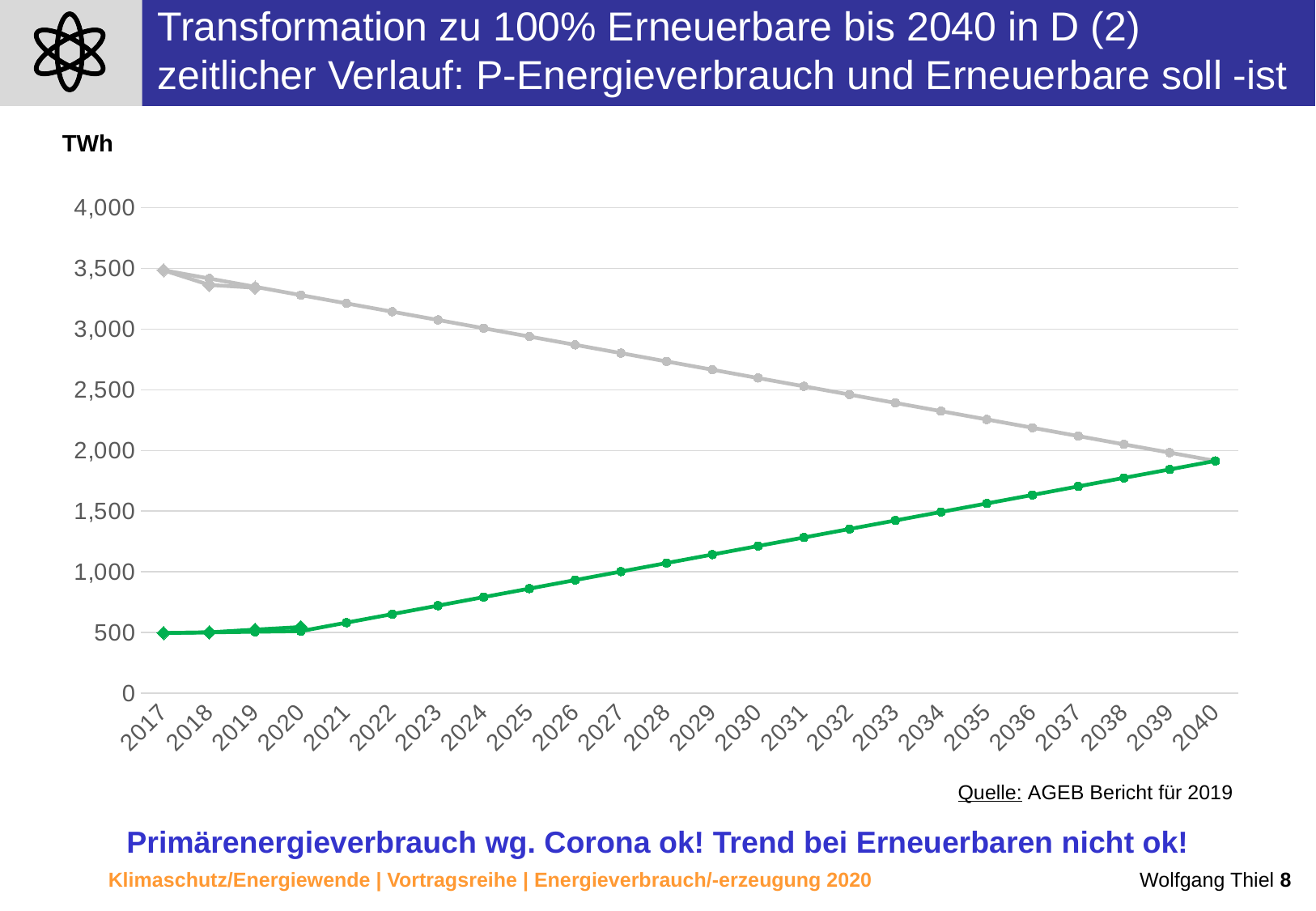
Is the value of the grey line in 2017 greater or less than 3,000? greater Is the value of the green line in 2017 greater or less than 1,000? less Which line has the larger value in 2017, the grey line or the green line? the grey line In which year does the grey line have its highest value? 2017 In which year does the green line reach its highest value? 2040 How many lines are plotted in the chart? 4 Does the grey line rise or fall from 2017 to 2040? falls Is the value of the green line in 2040 greater or less than 2,000? less How many years are shown on the x axis of the chart? 24 What type of chart is shown on the slide? line chart Does the green line rise or fall from 2017 to 2040? rises In which year does the grey line have its lowest value? 2040